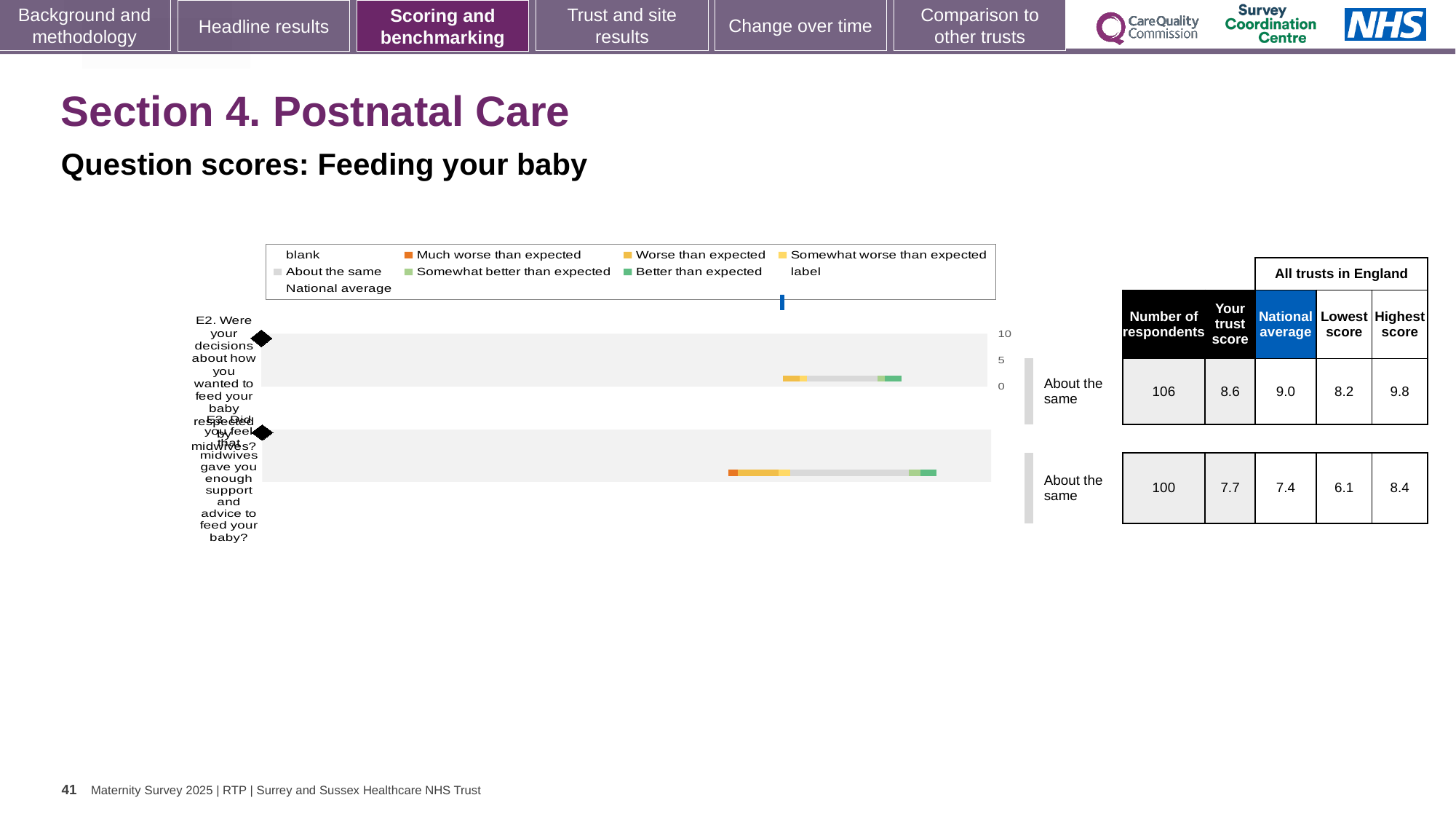
What is the difference between the national average and the trust score for question E2? 0.4 Which is larger for question E2: the trust score or the national average? National average What is the difference between the highest score and the lowest score for question E3? 2.3 What benchmark category is shown for both questions in the Feeding your baby chart? About the same What is the trust score for question E3 (midwives gave you enough support and advice to feed your baby)? 7.7 What is the trust score for question E2 (decisions about how you wanted to feed your baby respected by midwives)? 8.6 How many questions (categories) are plotted in the Feeding your baby chart? 2 What kind of chart is used to show the question scores for Feeding your baby? Bar chart How many respondents answered question E3? 100 Which question has the higher trust score, E2 or E3? E2 What is the national average score for question E2? 9.0 How many entries does the legend of the Feeding your baby chart list? 9